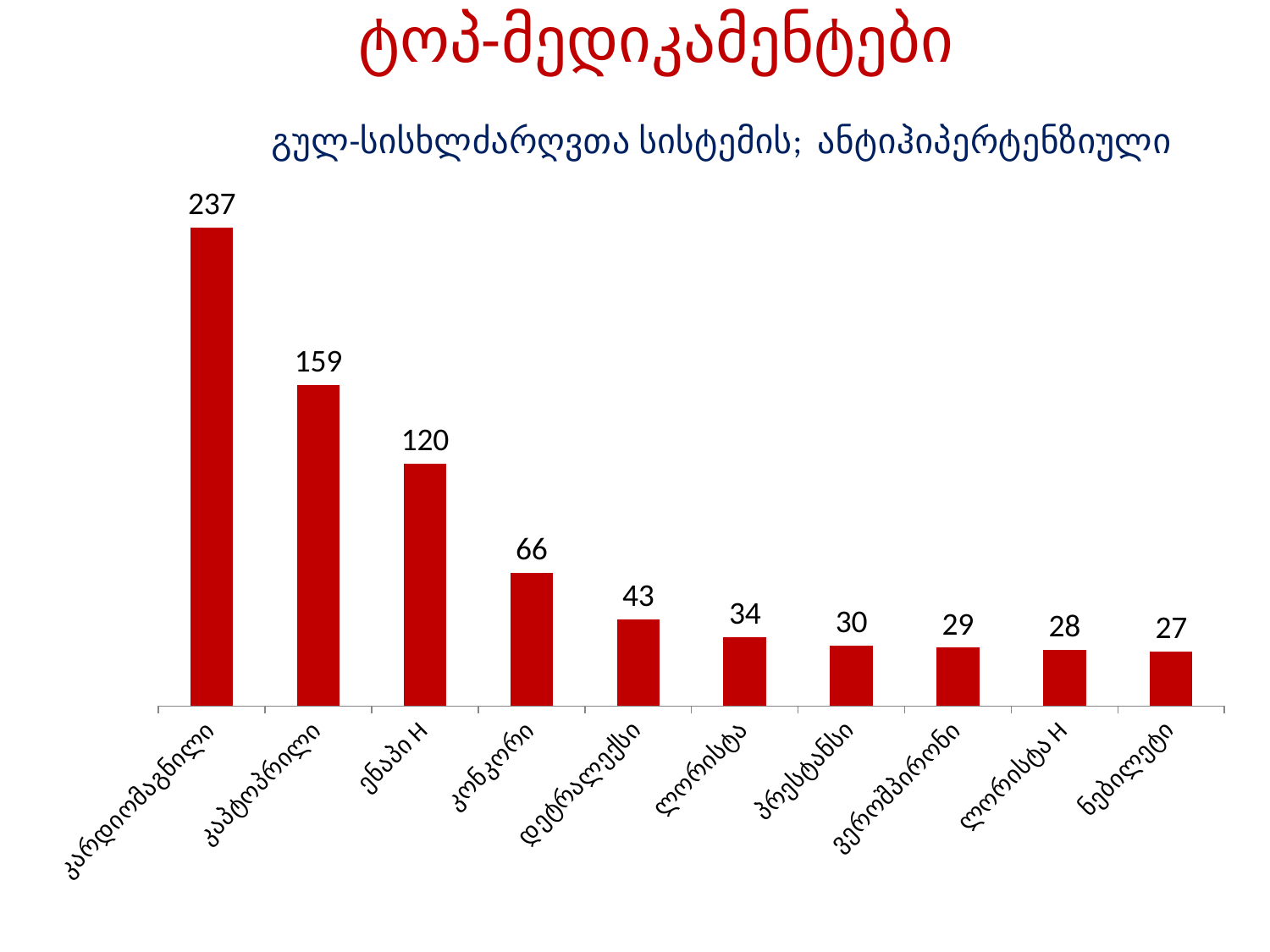
What is the title of the slide? ტოპ-მედიკამენტები What is the difference between the values for კარდიომაგნილი and კაპტოპრილი? 78 What kind of chart is shown on the slide? Bar chart Do the values rise or fall from left to right along the x axis? Fall How many categories are shown on the chart? 10 What is the value for კარდიომაგნილი? 237 What is the difference between the values for კონკორი and ლორისტა? 32 What is the value for დეტრალექსი? 43 Which category has the lowest value? ნებილეტი What is the value for ენაპი H? 120 Which category has the highest value? კარდიომაგნილი Which is larger, the value for კაპტოპრილი or the value for ენაპი H? კაპტოპრილი